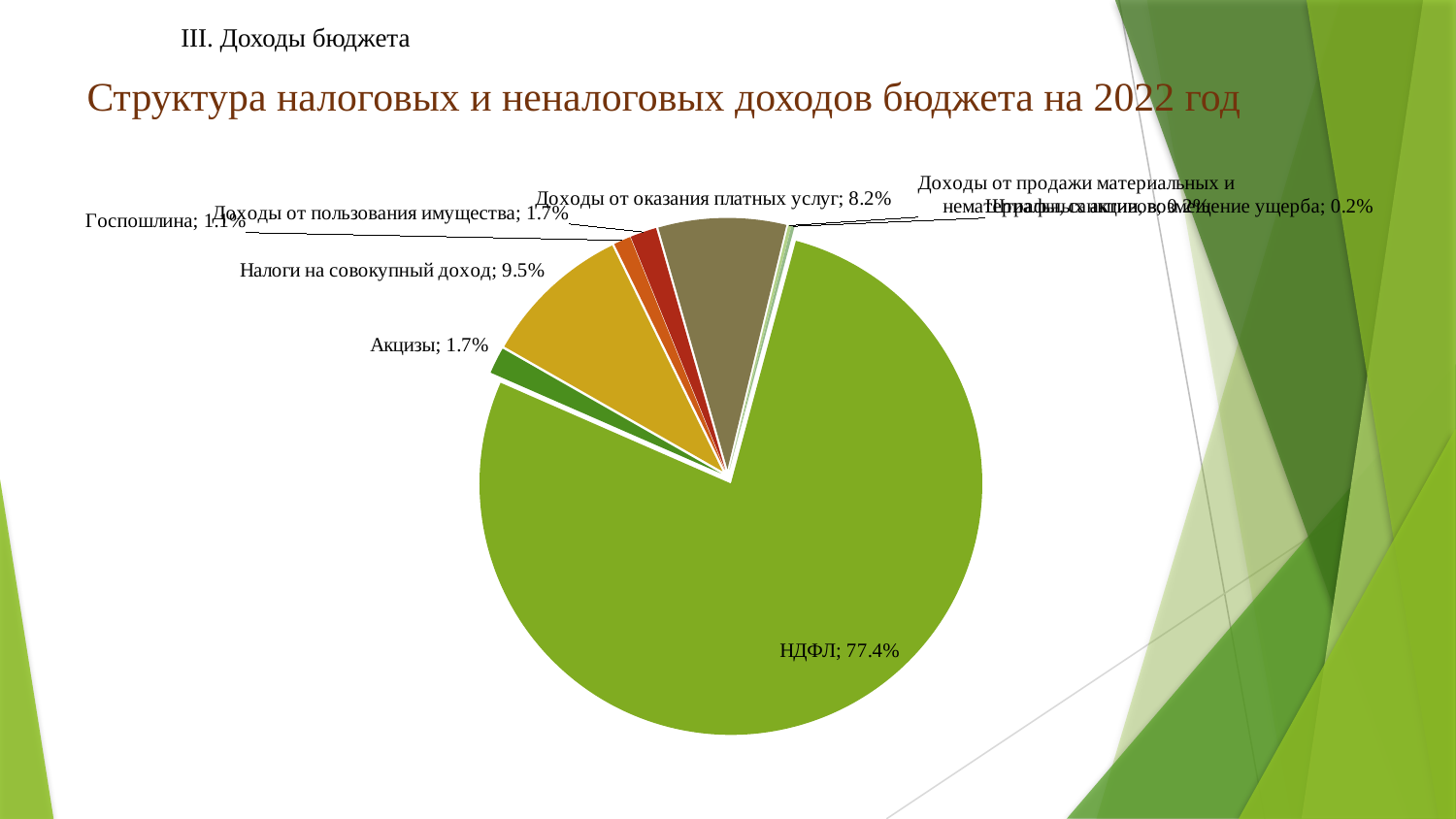
What share of the pie does НДФЛ have? 77.4% What is the difference between the shares of Налоги на совокупный доход and Доходы от оказания платных услуг? 1.3% Which category has the largest share of the pie? НДФЛ What is the title of the chart on the slide? Структура налоговых и неналоговых доходов бюджета на 2022 год What is the value shown for Налоги на совокупный доход? 9.5% What is the value shown for Доходы от оказания платных услуг? 8.2% What is the value shown for Госпошлина? 1.1% What is the value shown for Доходы от пользования имущества? 1.7% Which is larger, Налоги на совокупный доход or Доходы от оказания платных услуг? Налоги на совокупный доход What type of chart is shown on the slide? pie chart What is the value shown for Акцизы? 1.7% What is the difference between the shares of НДФЛ and Налоги на совокупный доход? 67.9%